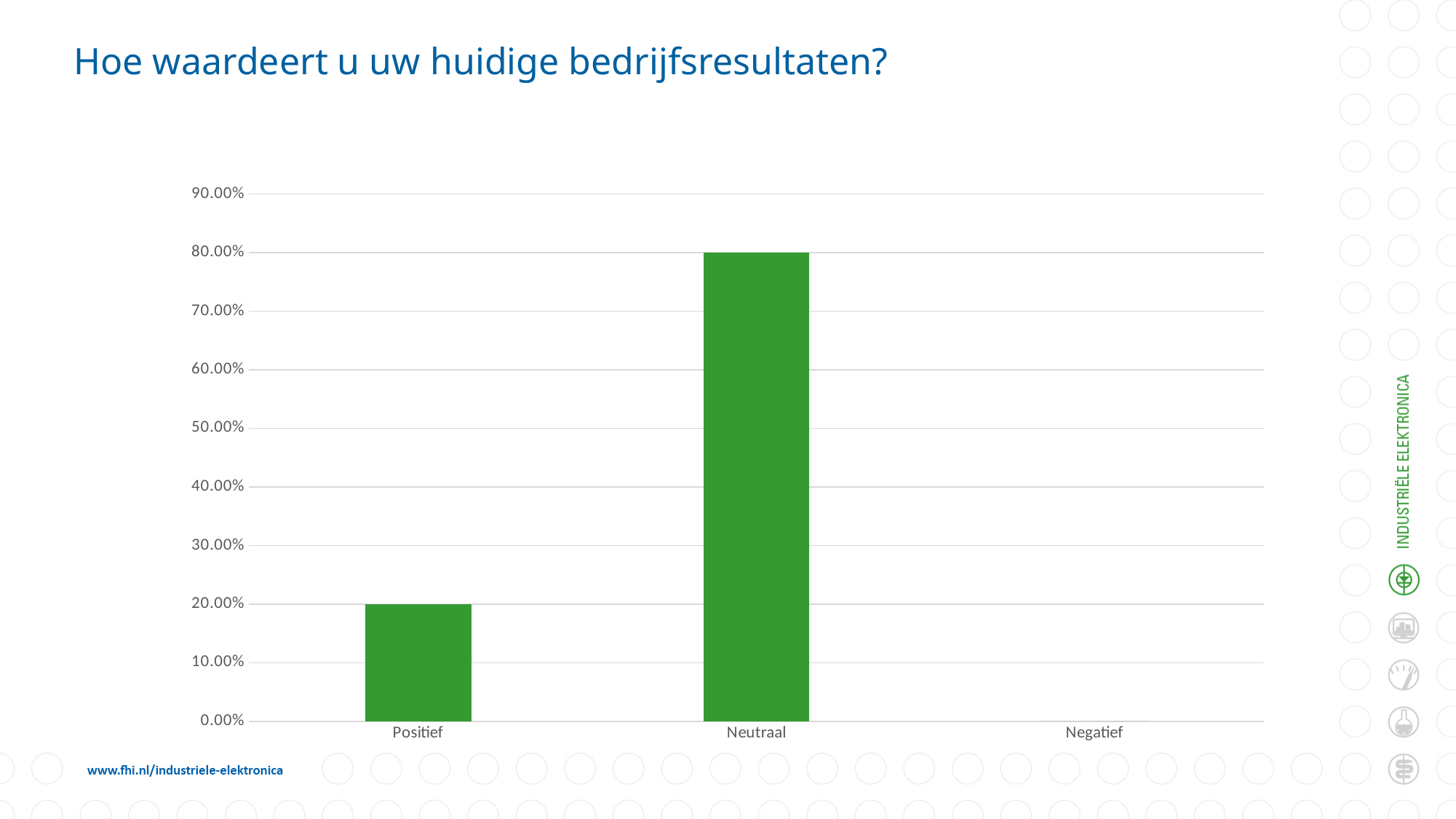
Is the value for Neutraal greater or less than 50.00%? greater What is the title of the slide containing the chart? Hoe waardeert u uw huidige bedrijfsresultaten? How many categories are shown on the x axis of the chart? 3 What is the value for Positief? 20.00% What is the value for Neutraal? 80.00% What type of chart is shown on the slide? bar chart Which is larger, the value for Positief or the value for Neutraal? Neutraal Which category has the highest value? Neutraal Which category has the lowest value? Negatief Is the value for Positief greater or less than 30.00%? less What is the difference between the values for Neutraal and Positief? 60.00% What is the value for Negatief? 0.00%